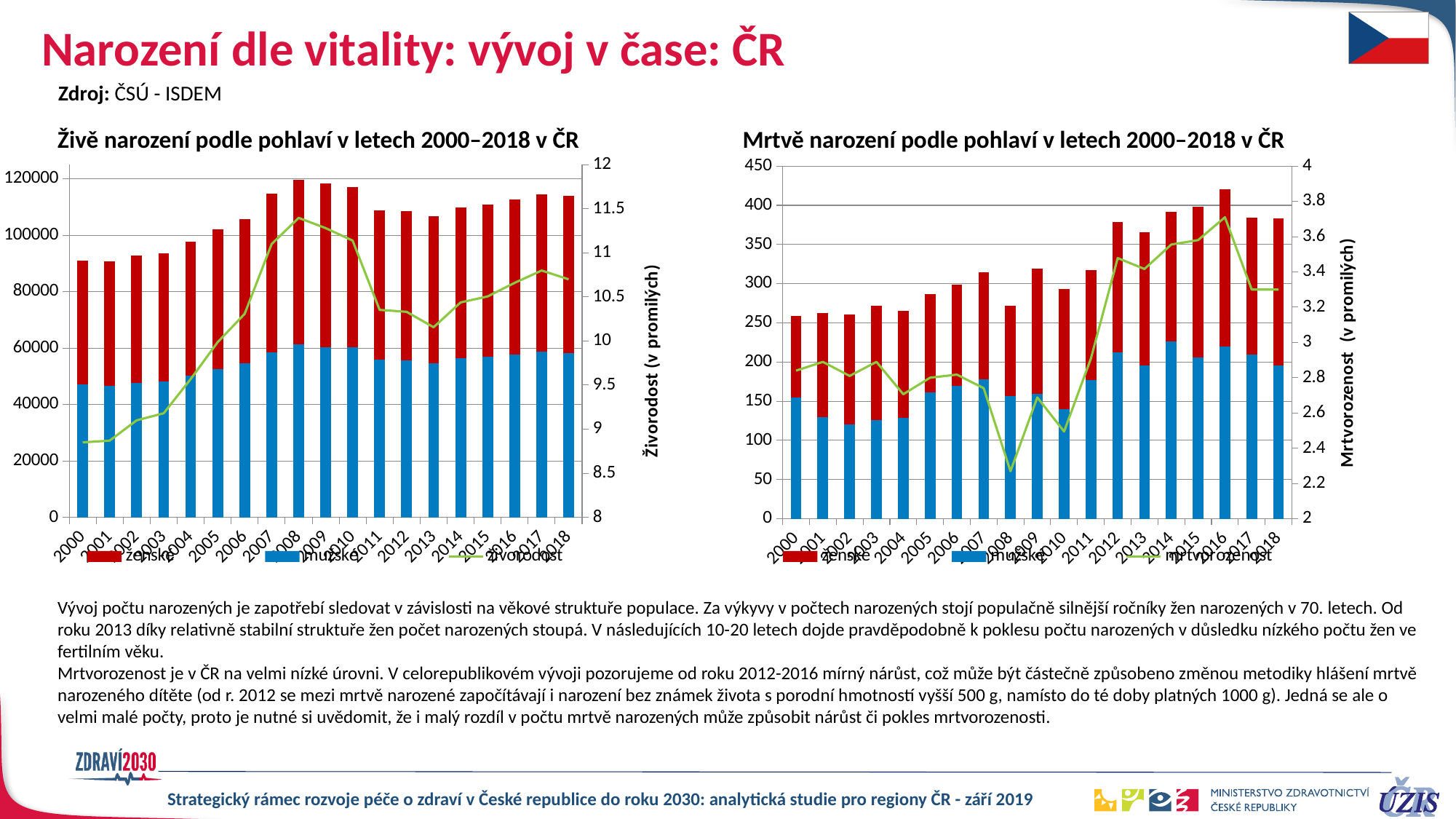
In the right chart (Mrtvě narození), which year has the lowest mrtvorozenost value? 2008 In the right chart (Mrtvě narození), is the mrtvorozenost value for 2008 greater or less than 2.4? less In the right chart (Mrtvě narození), is the total bar for 2016 larger or smaller than the total bar for 2008? larger In the left chart (Živě narození), which year has the highest total bar? 2008 What kind of chart is the left chart titled "Živě narození podle pohlaví v letech 2000–2018 v ČR"? A stacked bar chart with a line series In the left chart (Živě narození), how many years are shown on the x axis? 19 In the left chart (Živě narození), is the total bar for 2008 greater or less than 100000? greater In the right chart (Mrtvě narození), which year has the highest total bar? 2016 What is the title of the secondary (right-hand) axis of the right chart (Mrtvě narození)? Mrtvorozenost (v promilých) In the left chart (Živě narození), is the živorodost value for 2013 greater or less than 10.5? less In the left chart (Živě narození), how many series does the legend list? 3 In the left chart (Živě narození), which year has the highest živorodost value? 2008